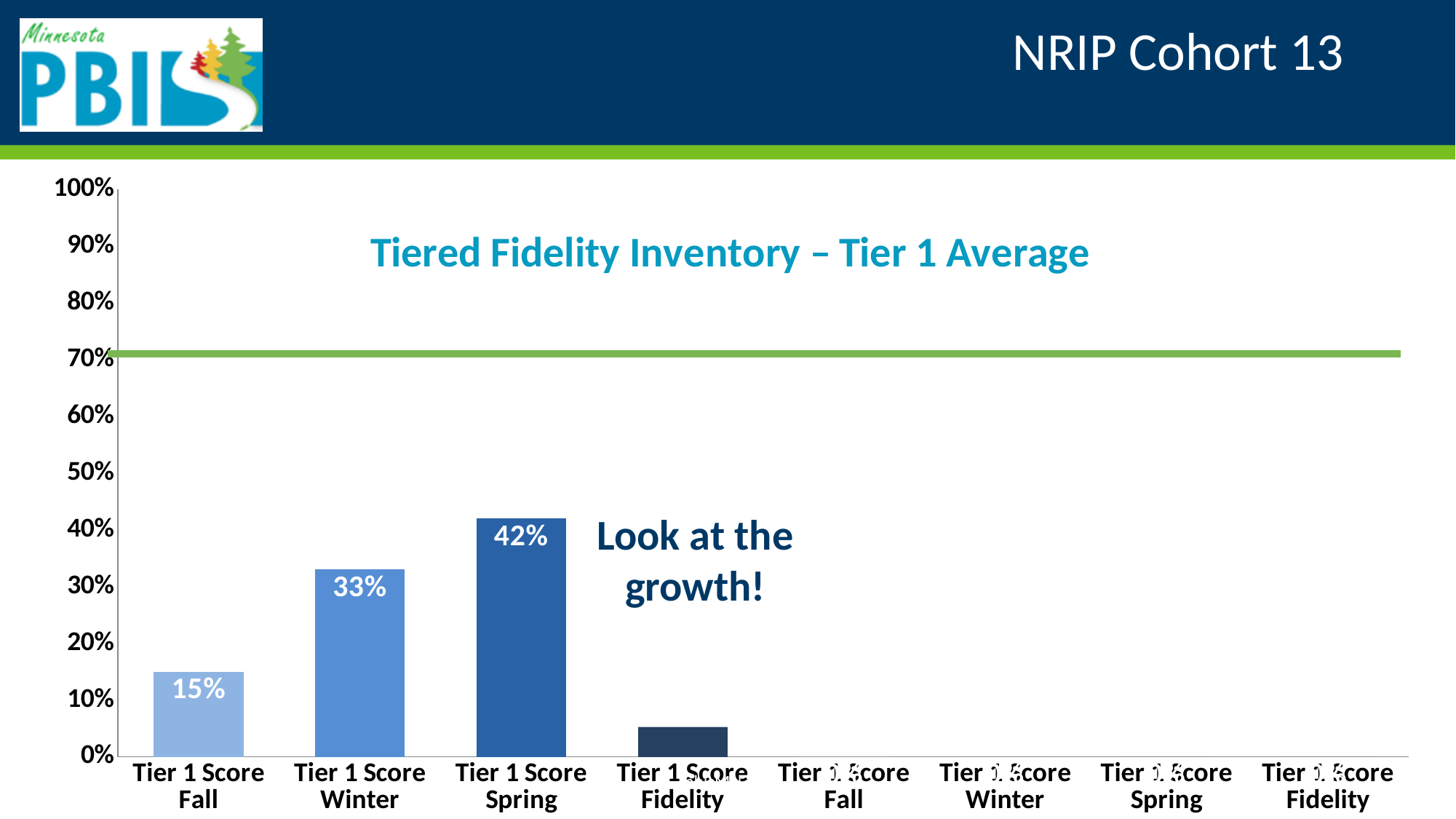
Do the values rise or fall from Tier 1 Score Fall to Tier 1 Score Spring? rise At what percentage is the green horizontal line drawn across the chart? 70% What is the difference between the Tier 1 Score Spring and Tier 1 Score Fall values? 27% What is the value for Tier 1 Score Fall? 15% Is the value for Tier 1 Score Fidelity greater or less than 10%? less Which is larger, Tier 1 Score Winter or Tier 1 Score Spring? Tier 1 Score Spring Which plotted bar is the lowest? Tier 1 Score Fidelity What is the difference between the Tier 1 Score Winter and Tier 1 Score Fall values? 18% What is the value for Tier 1 Score Spring? 42% What kind of chart is shown on the slide? bar chart What is the value for Tier 1 Score Winter? 33% Which category has the highest value? Tier 1 Score Spring